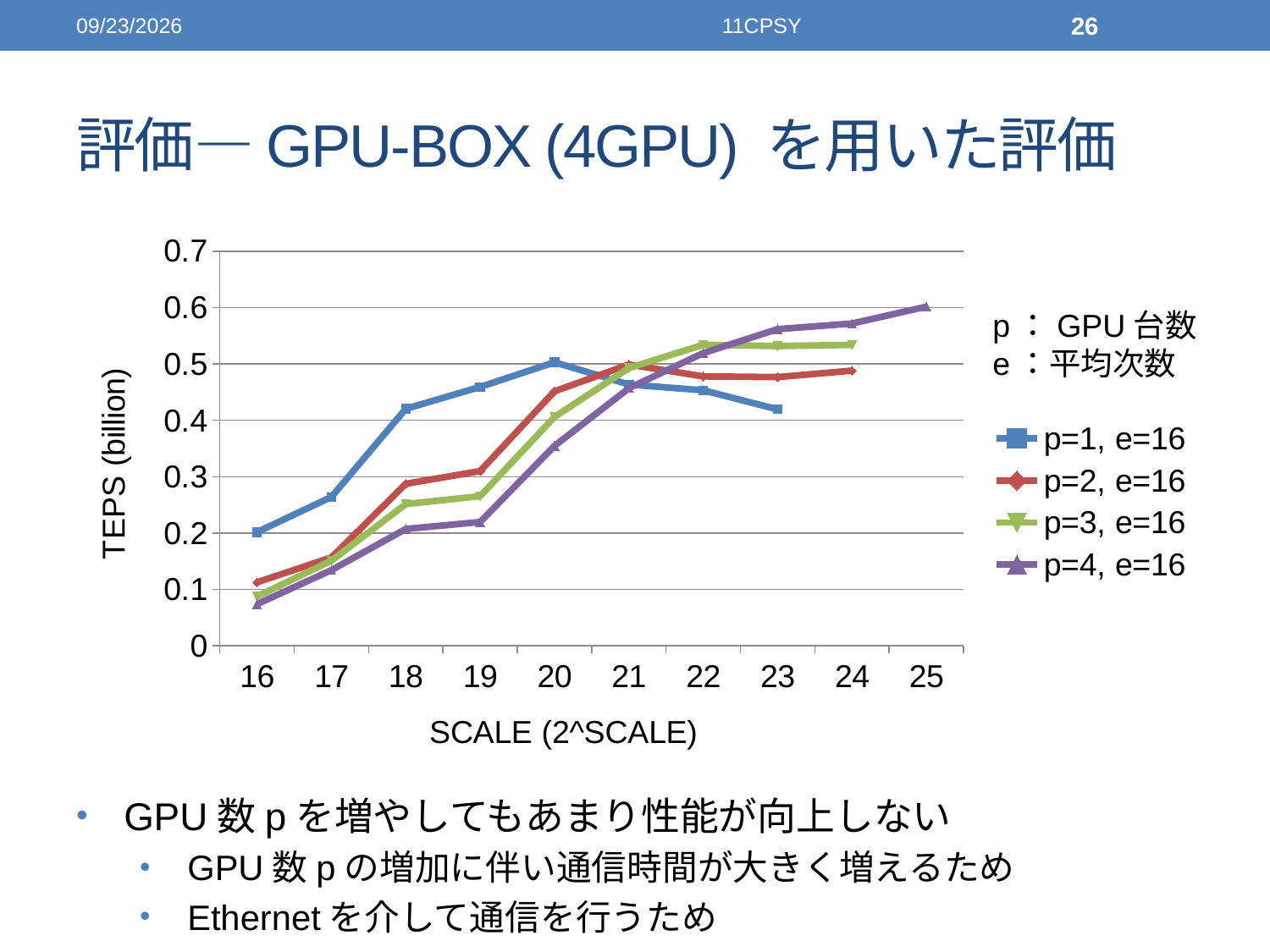
Does the p=4, e=16 series rise or fall as SCALE increases from 16 to 25? rise How many SCALE values are marked along the x axis? 10 Is the value for p=4, e=16 at SCALE 20 greater or less than 0.3? greater What is the title of the y axis? TEPS (billion) Is the value for p=4, e=16 at SCALE 25 greater or less than 0.5? greater What kind of chart is shown on the slide? line chart Is the value for p=1, e=16 at SCALE 23 greater or less than 0.5? less How many series does the legend list? 4 What is the title of the x axis? SCALE (2^SCALE) At SCALE 18, which is larger: p=1, e=16 or p=4, e=16? p=1, e=16 Which series has the highest value at SCALE 16? p=1, e=16